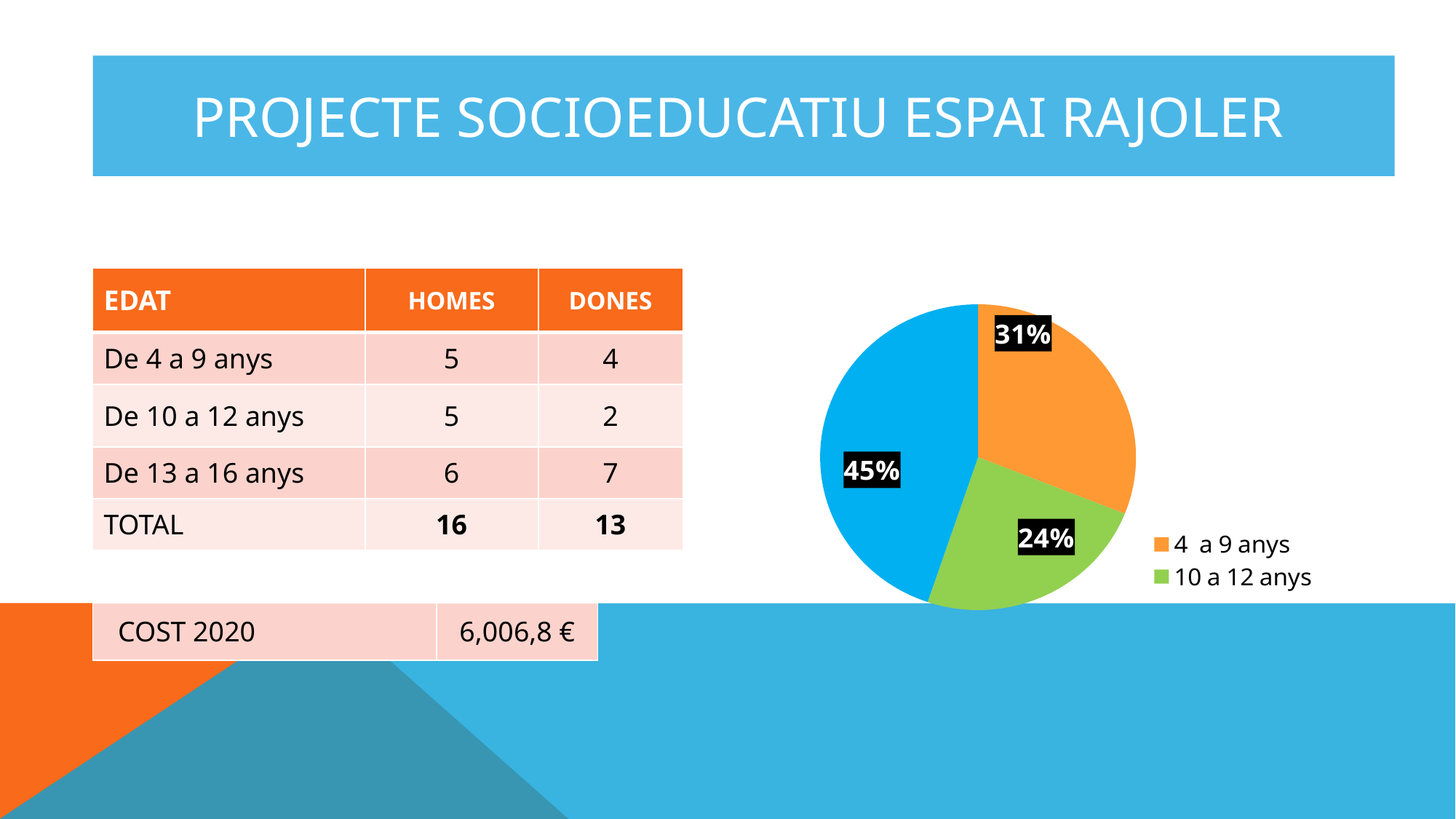
What share of the pie does the '10 a 12 anys' slice represent? 24% Is the share of the '4 a 9 anys' slice greater or less than 30%? greater How many slices does the pie chart have? 3 What percentage is shown on the largest slice of the pie chart? 45% Which slice is larger, '4 a 9 anys' or '10 a 12 anys'? 4 a 9 anys Is the share of the blue slice greater or less than 50%? less What colour is the '10 a 12 anys' slice in the pie chart? Green What is the difference in percentage points between the '4 a 9 anys' slice and the '10 a 12 anys' slice? 7 percentage points What colour is the '4 a 9 anys' slice in the pie chart? Orange What share of the pie does the '4 a 9 anys' slice represent? 31% Which of the labelled legend categories has the smallest slice in the pie chart? 10 a 12 anys What kind of chart is shown on the slide? Pie chart